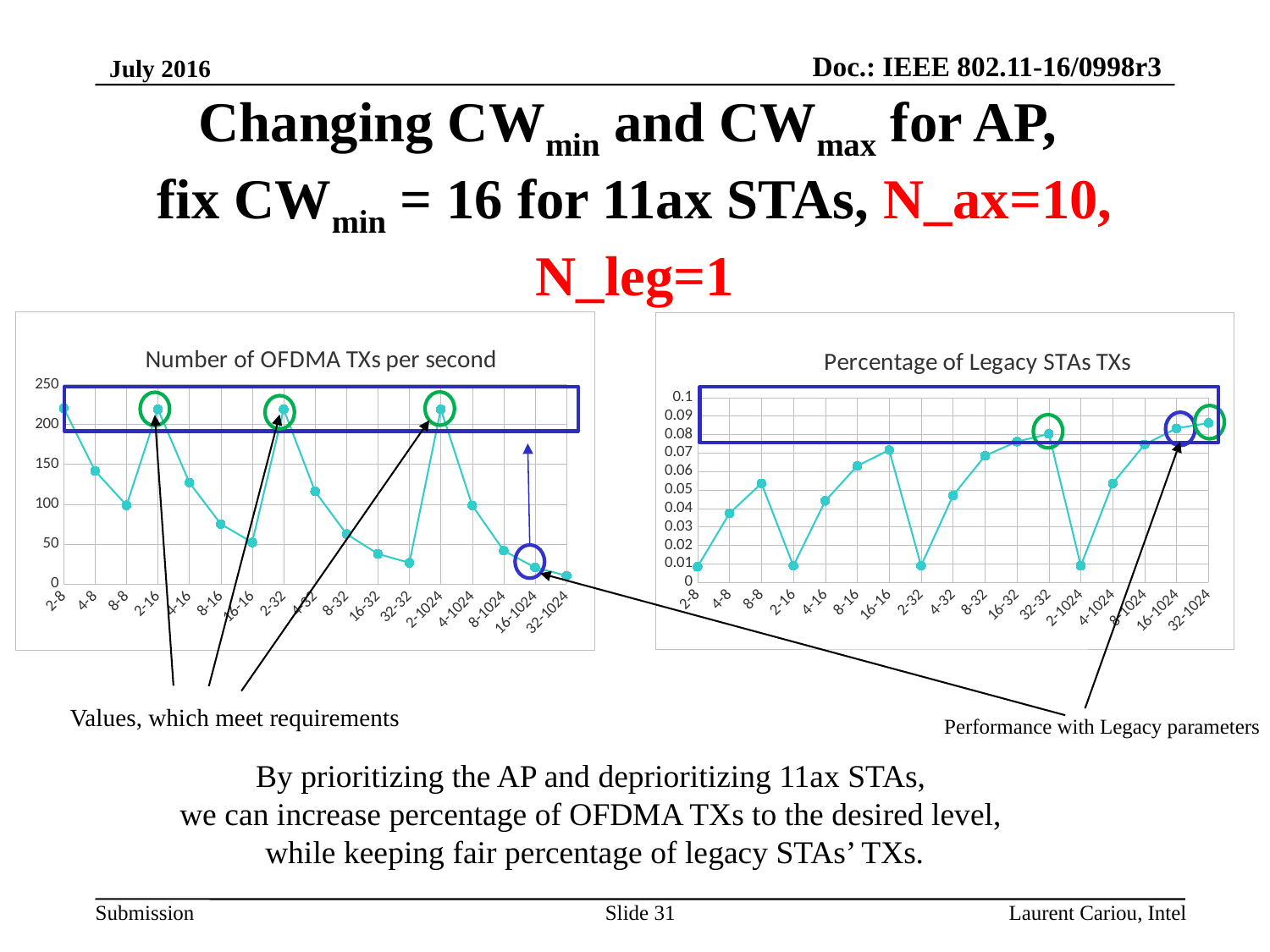
In the 'Number of OFDMA TXs per second' chart, do the values rise or fall from 2-1024 to 32-1024? fall What is the title of the chart on the right side of the slide? Percentage of Legacy STAs TXs In the 'Number of OFDMA TXs per second' chart, which is larger, the value for 2-16 or the value for 4-16? 2-16 In the 'Number of OFDMA TXs per second' chart, is the value for 16-16 greater or less than 100? less In the 'Percentage of Legacy STAs TXs' chart, is the value for 2-32 greater or less than 0.02? less What kind of chart is the 'Number of OFDMA TXs per second' chart? line chart How many categories are shown on the x axis of the 'Percentage of Legacy STAs TXs' chart? 17 In the 'Percentage of Legacy STAs TXs' chart, which category has the highest value? 32-1024 In the 'Percentage of Legacy STAs TXs' chart, is the value for 16-16 greater or less than 0.05? greater In the 'Percentage of Legacy STAs TXs' chart, which is larger, the value for 8-8 or the value for 16-32? 16-32 In the 'Number of OFDMA TXs per second' chart, which category has the lowest value? 32-1024